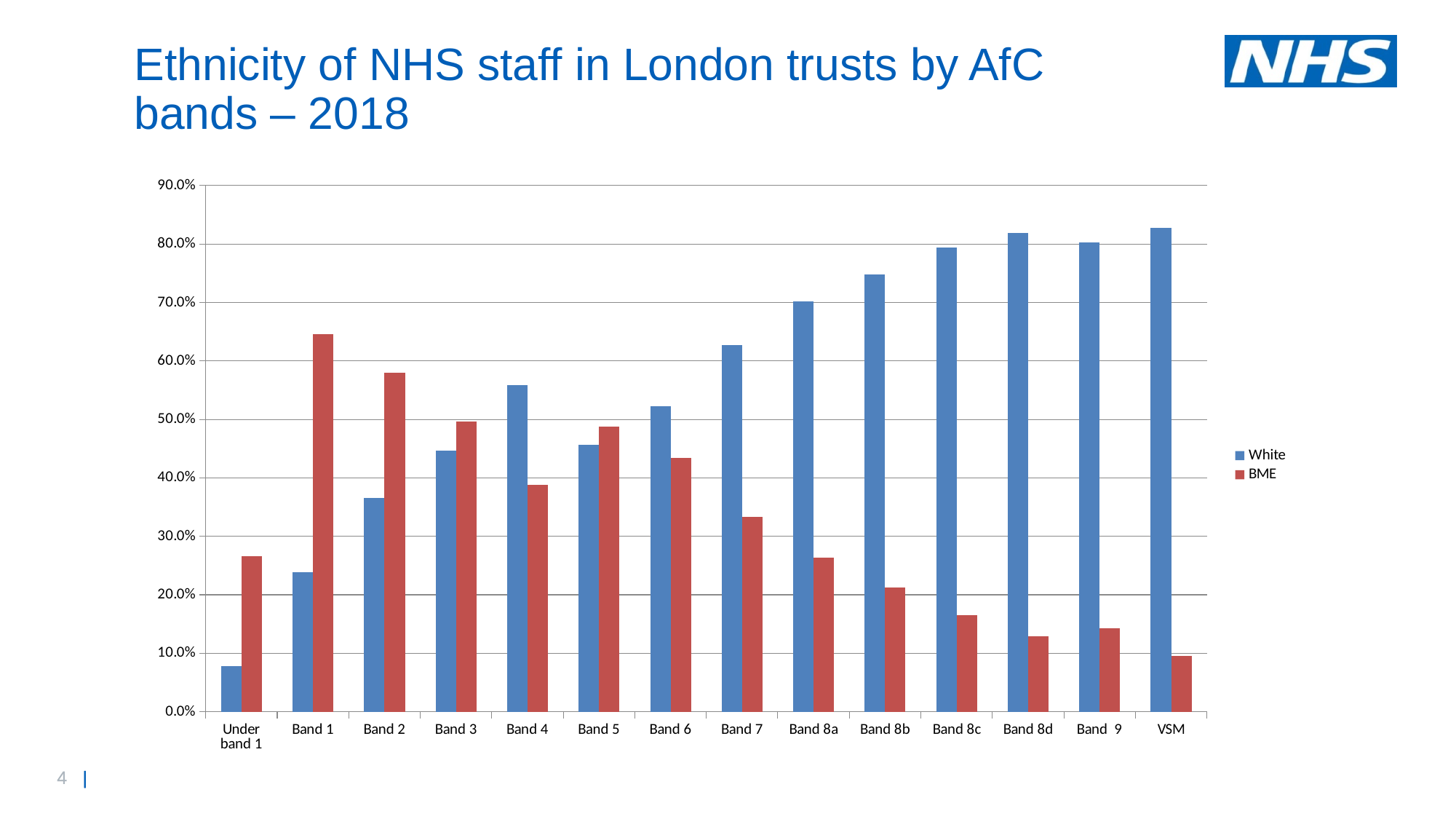
What kind of chart is shown on the slide? Bar chart How many AfC band categories are shown on the x axis? 14 Which band has the lowest BME value? VSM Which band has the lowest White value? Under band 1 Which band has the highest BME value? Band 1 Is the BME value for Band 8c greater or less than 20.0%? less For Band 3, which is larger, the White value or the BME value? BME Is the White value for Band 2 greater or less than 40.0%? less How many series does the legend list? 2 Is the White value for Band 7 greater or less than 60.0%? greater Does the White series generally rise or fall from Under band 1 to VSM? Rise